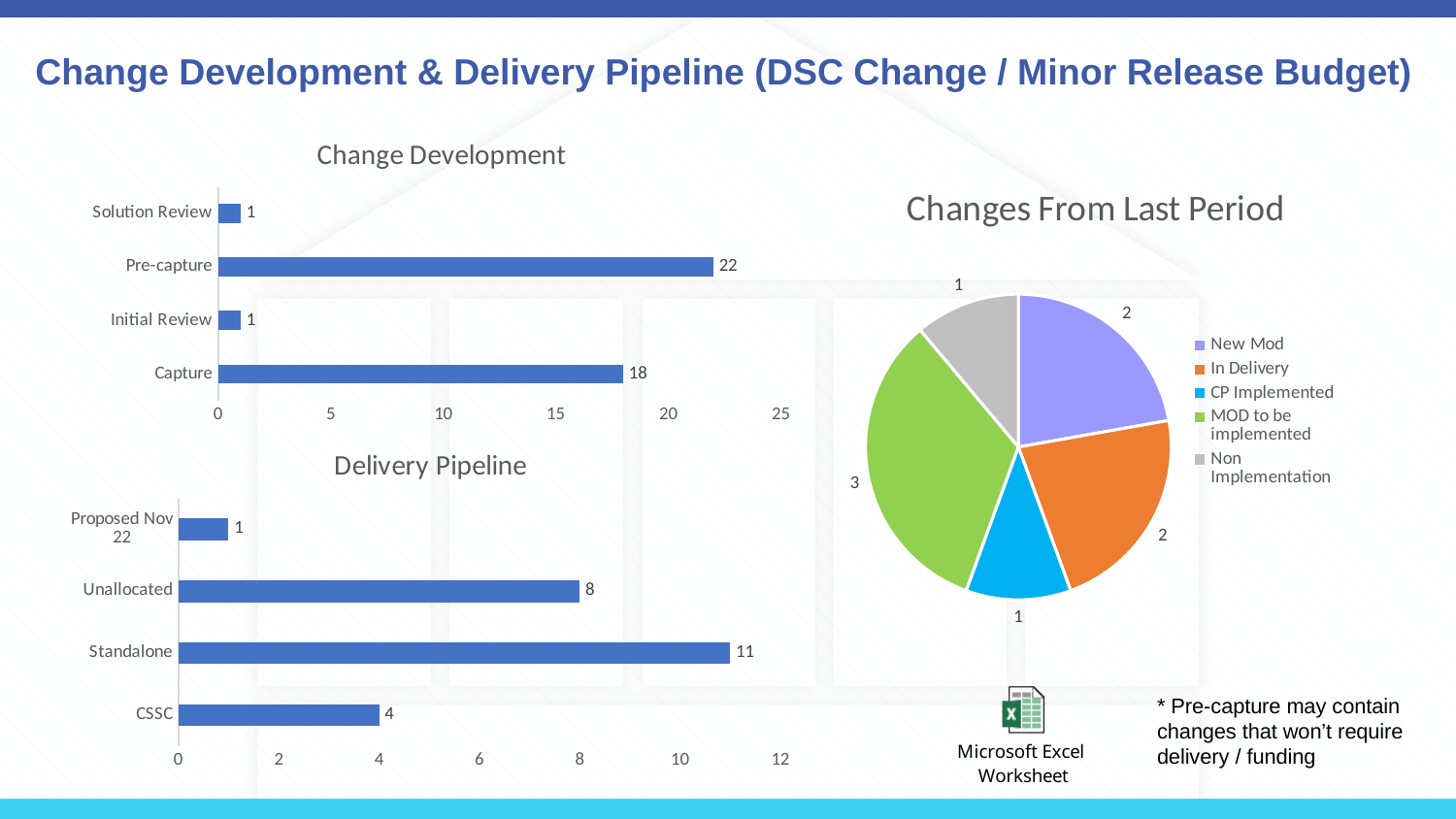
In the Change Development chart, what is the value for Pre-capture? 22 How many series does the legend of the Changes From Last Period pie chart list? 5 In the Change Development chart, which category has the highest value? Pre-capture In the Changes From Last Period pie chart, what is the value for MOD to be implemented? 3 In the Delivery Pipeline chart, what is the value for Standalone? 11 What kind of chart is the Delivery Pipeline chart? Bar chart In the Change Development chart, how many categories are shown? 4 In the Change Development chart, what is the difference between Pre-capture and Capture? 4 In the Delivery Pipeline chart, which is larger, Unallocated or CSSC? Unallocated In the Changes From Last Period pie chart, what is the total of all slices? 9 In the Delivery Pipeline chart, what is the difference between Standalone and Unallocated? 3 In the Delivery Pipeline chart, which category has the lowest value? Proposed Nov 22